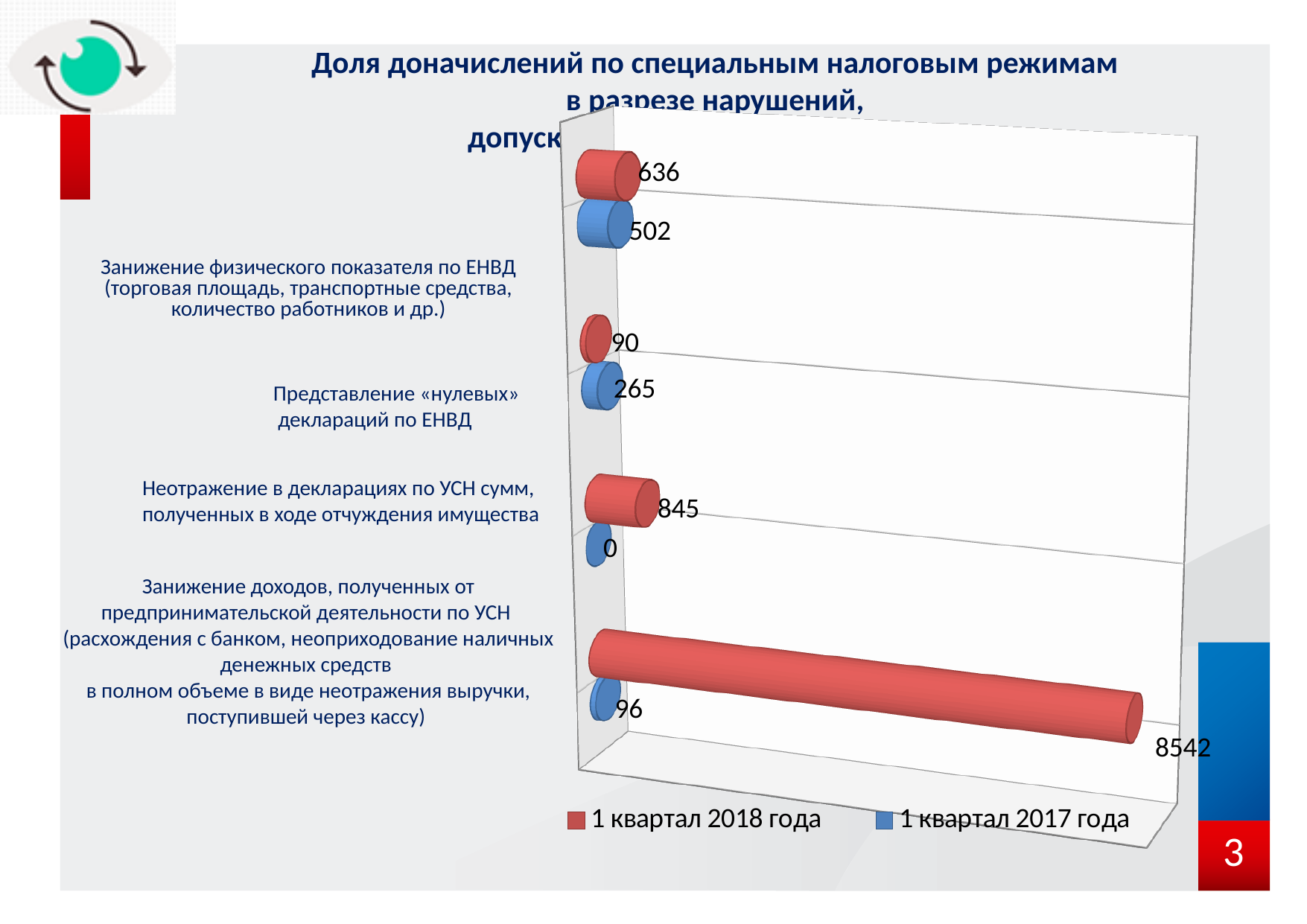
For «Представление «нулевых» деклараций по ЕНВД», which series has the larger value: 1 квартал 2018 года or 1 квартал 2017 года? 1 квартал 2017 года What kind of chart is shown on the slide? bar chart How many series does the legend list? 2 What is the value for «Занижение физического показателя по ЕНВД» in 1 квартал 2018 года? 636 What is the value for «Неотражение в декларациях по УСН сумм, полученных в ходе отчуждения имущества» in 1 квартал 2018 года? 845 Which colour represents the series 1 квартал 2017 года in the chart? blue How many categories (violation types) are plotted in the chart? 4 Which category has the lowest value for 1 квартал 2017 года? Неотражение в декларациях по УСН сумм, полученных в ходе отчуждения имущества What is the difference between the 1 квартал 2018 года and 1 квартал 2017 года values for «Занижение физического показателя по ЕНВД»? 134 What is the value for «Занижение физического показателя по ЕНВД» in 1 квартал 2017 года? 502 What is the value for «Представление «нулевых» деклараций по ЕНВД» in 1 квартал 2017 года? 265 Which category has the highest value for 1 квартал 2018 года? Занижение доходов, полученных от предпринимательской деятельности по УСН